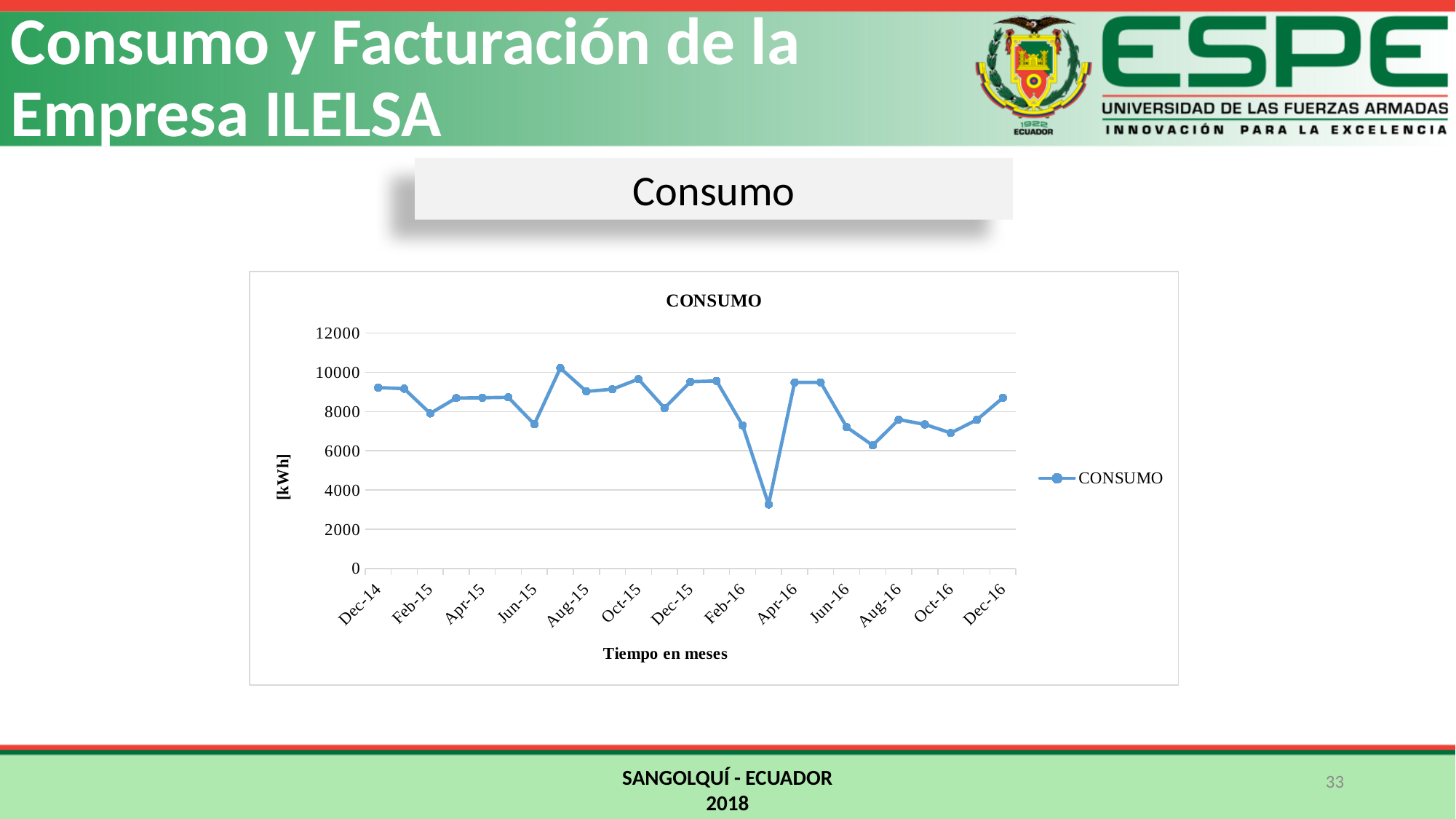
What is the title of the chart? CONSUMO What kind of chart is shown on the slide? line chart Do the values rise or fall from Apr-16 to Aug-16? fall Is the value for Dec-14 greater or less than 8000? greater Is the value for Apr-16 greater or less than 8000? greater Is the value for Jun-15 greater or less than 8000? less How many series does the legend list? 1 What unit is shown on the vertical axis label? [kWh] How many month labels are shown along the x axis? 13 Which has the larger value, Dec-14 or Jun-15? Dec-14